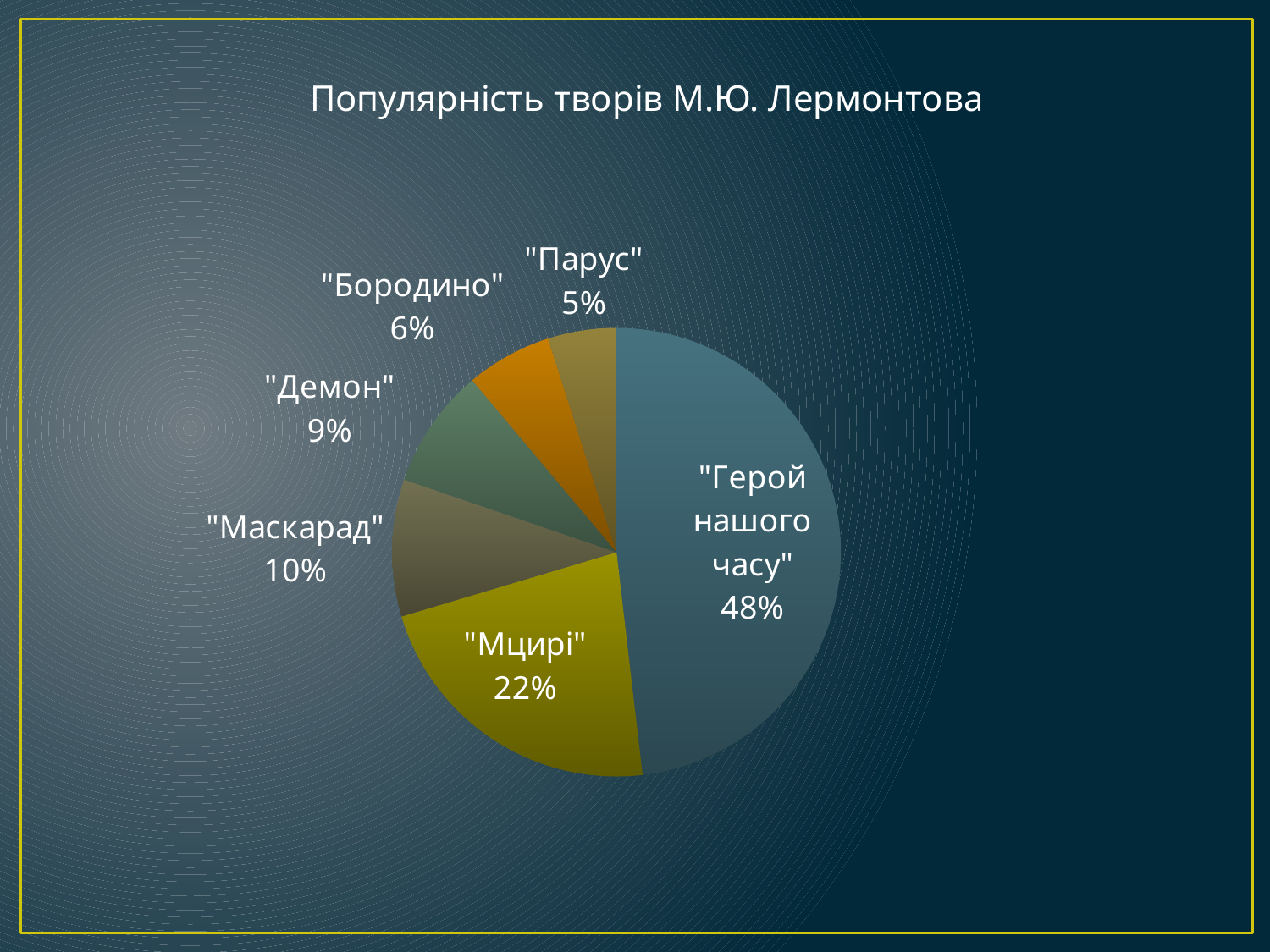
What is the value shown for "Мцирі"? 22% What is the value shown for "Бородино"? 6% Which is larger, the share for "Маскарад" or the share for "Демон"? "Маскарад" Which work has the largest slice of the pie? "Герой нашого часу" What kind of chart is shown on the slide? Pie chart How many works (slices) are shown in the pie chart? 6 What is the value shown for "Маскарад"? 10% What is the value shown for "Демон"? 9% Which work has the smallest slice of the pie? "Парус" What is the difference in percentage points between "Герой нашого часу" and "Мцирі"? 26 What share of the pie does "Герой нашого часу" have? 48% What is the title of the chart? Популярність творів М.Ю. Лермонтова